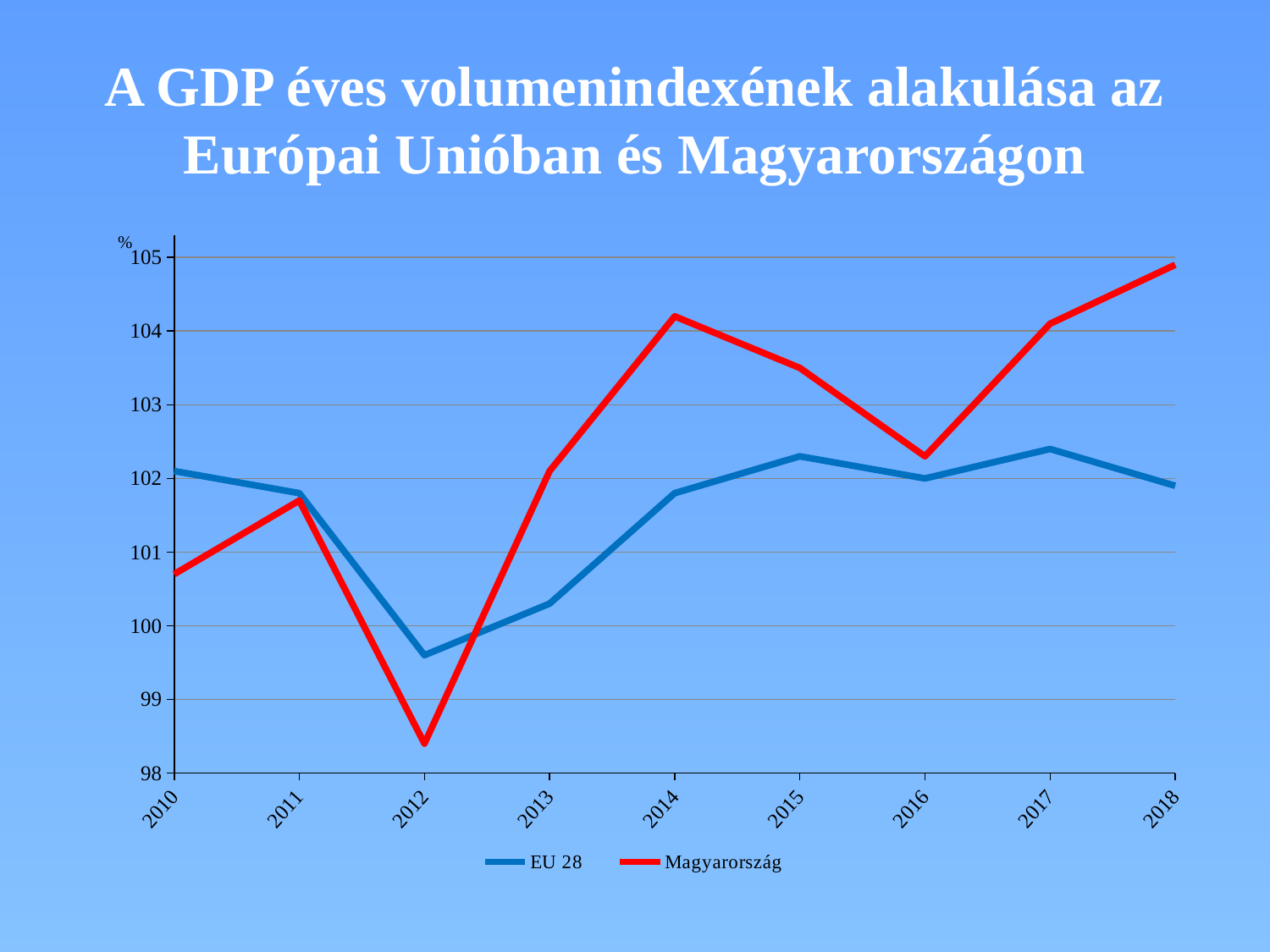
In which year does the Magyarország series reach its lowest value? 2012 Which series has the larger value in 2014, EU 28 or Magyarország? Magyarország In which year does the EU 28 series reach its lowest value? 2012 How many series does the legend list? 2 In which year does the Magyarország series reach its highest value? 2018 Which series has the larger value in 2010, EU 28 or Magyarország? EU 28 Is the value for Magyarország in 2018 greater or less than 104? greater Is the value for EU 28 in 2012 greater or less than 100? less What kind of chart is shown on the slide? line chart Does the Magyarország series rise or fall from 2016 to 2018? rise Is the value for Magyarország in 2012 greater or less than 99? less How many years are shown on the x axis? 9